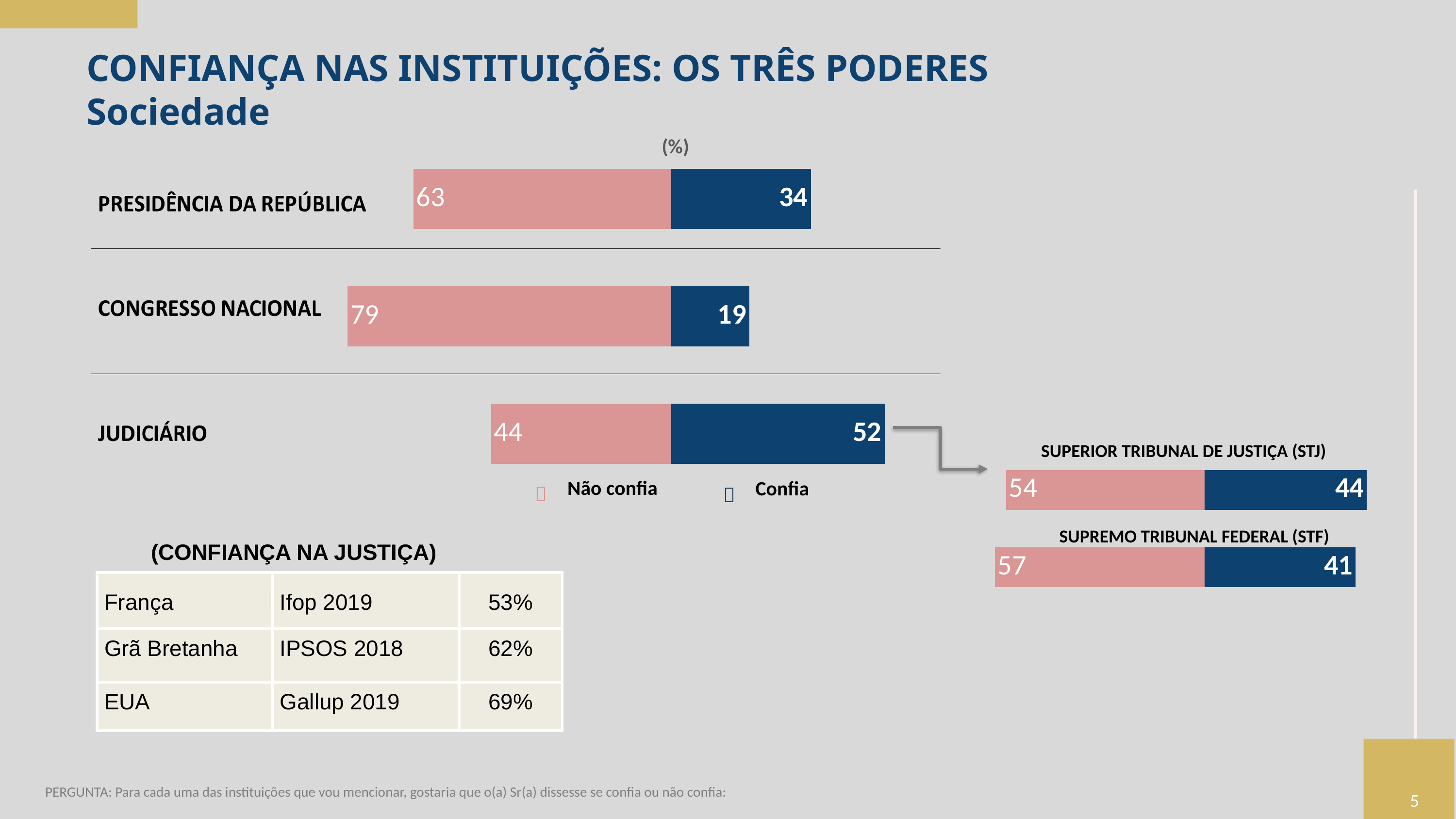
In the main chart on the left, what is the 'Não confia' value for Congresso Nacional? 79 In the chart on the right, what is the difference between the 'Não confia' values for STF and STJ? 3 In the main chart on the left, which institution has the lowest 'Confia' value? Congresso Nacional What kind of chart is the main chart on the left? Bar chart In the chart on the right, what is the 'Confia' value for Supremo Tribunal Federal (STF)? 41 How many institutions are shown in the main chart on the left? 3 In the main chart on the left, which is larger for Presidência da República: 'Não confia' or 'Confia'? Não confia In the main chart on the left, which institution has the highest 'Confia' value? Judiciário In the main chart on the left, what is the 'Confia' value for Judiciário? 52 In the main chart on the left, what is the 'Confia' value for Presidência da República? 34 In the main chart on the left, what is the difference between the 'Não confia' values for Congresso Nacional and Judiciário? 35 How many series does the legend of the main chart on the left list? 2